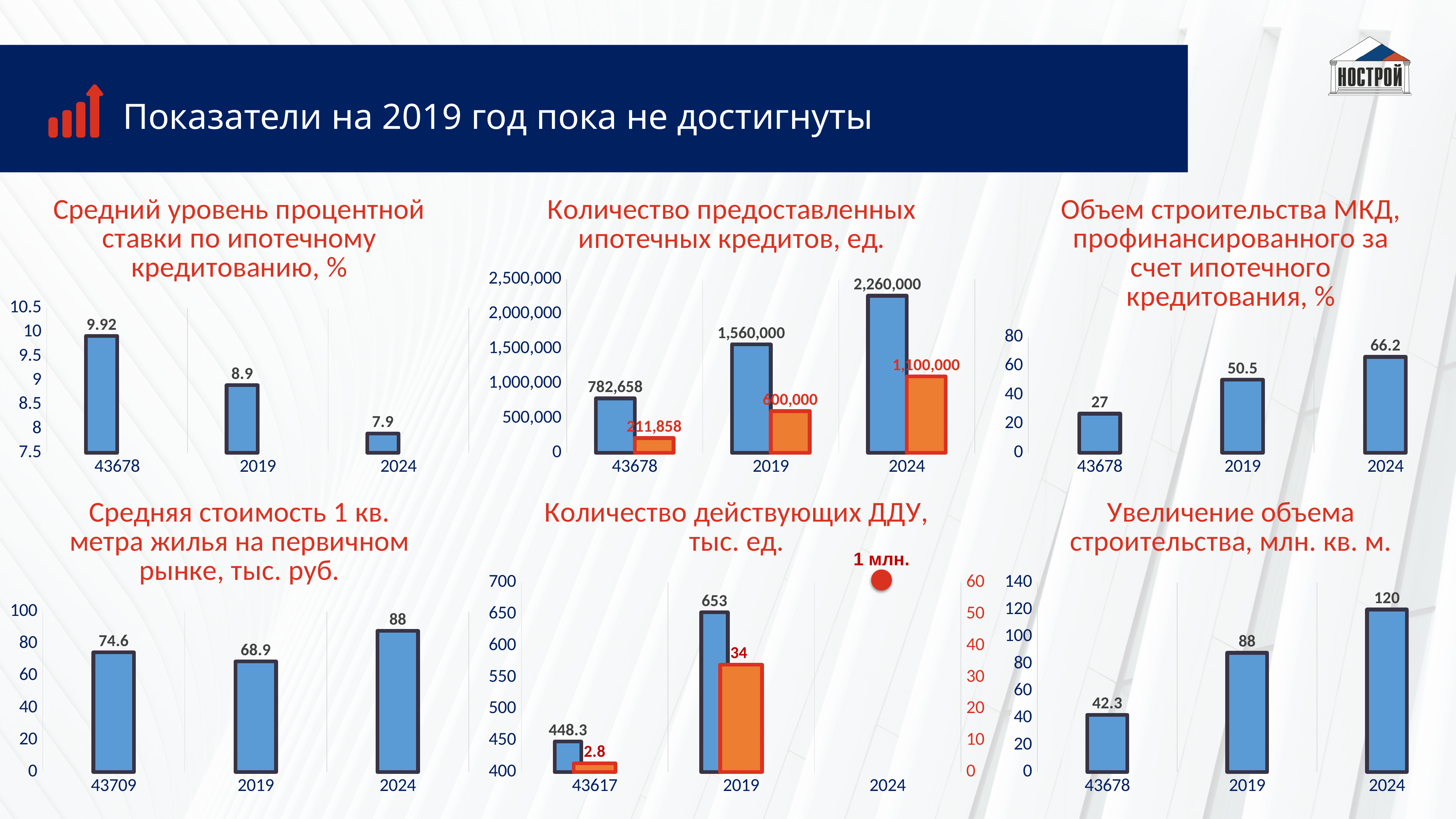
In the chart 'Количество предоставленных ипотечных кредитов, ед.', what is the difference between the blue bar and the orange bar for 2024? 1,160,000 In the chart 'Средняя стоимость 1 кв. метра жилья на первичном рынке, тыс. руб.', how many categories are shown on the x axis? 3 In the chart 'Количество предоставленных ипотечных кредитов, ед.', what is the value of the blue bar for 2019? 1,560,000 In the chart 'Объем строительства МКД, профинансированного за счет ипотечного кредитования, %', what is the value for 2019? 50.5 In the chart 'Количество предоставленных ипотечных кредитов, ед.', what is the value of the orange bar for 43678? 211,858 In the chart 'Средний уровень процентной ставки по ипотечному кредитованию, %', which category has the highest value? 43678 In the chart 'Средний уровень процентной ставки по ипотечному кредитованию, %', do the values rise or fall from left to right along the x axis? fall In the chart 'Средняя стоимость 1 кв. метра жилья на первичном рынке, тыс. руб.', which is larger, the value for 43709 or the value for 2019? 43709 In the chart 'Увеличение объема строительства, млн. кв. м.', what is the difference between the values for 2024 and 2019? 32 In the chart 'Количество действующих ДДУ, тыс. ед.', what is the value of the orange bar for 2019? 34 In the chart 'Средний уровень процентной ставки по ипотечному кредитованию, %', what is the value for 2024? 7.9 In the chart 'Объем строительства МКД, профинансированного за счет ипотечного кредитования, %', which category has the lowest value? 43678